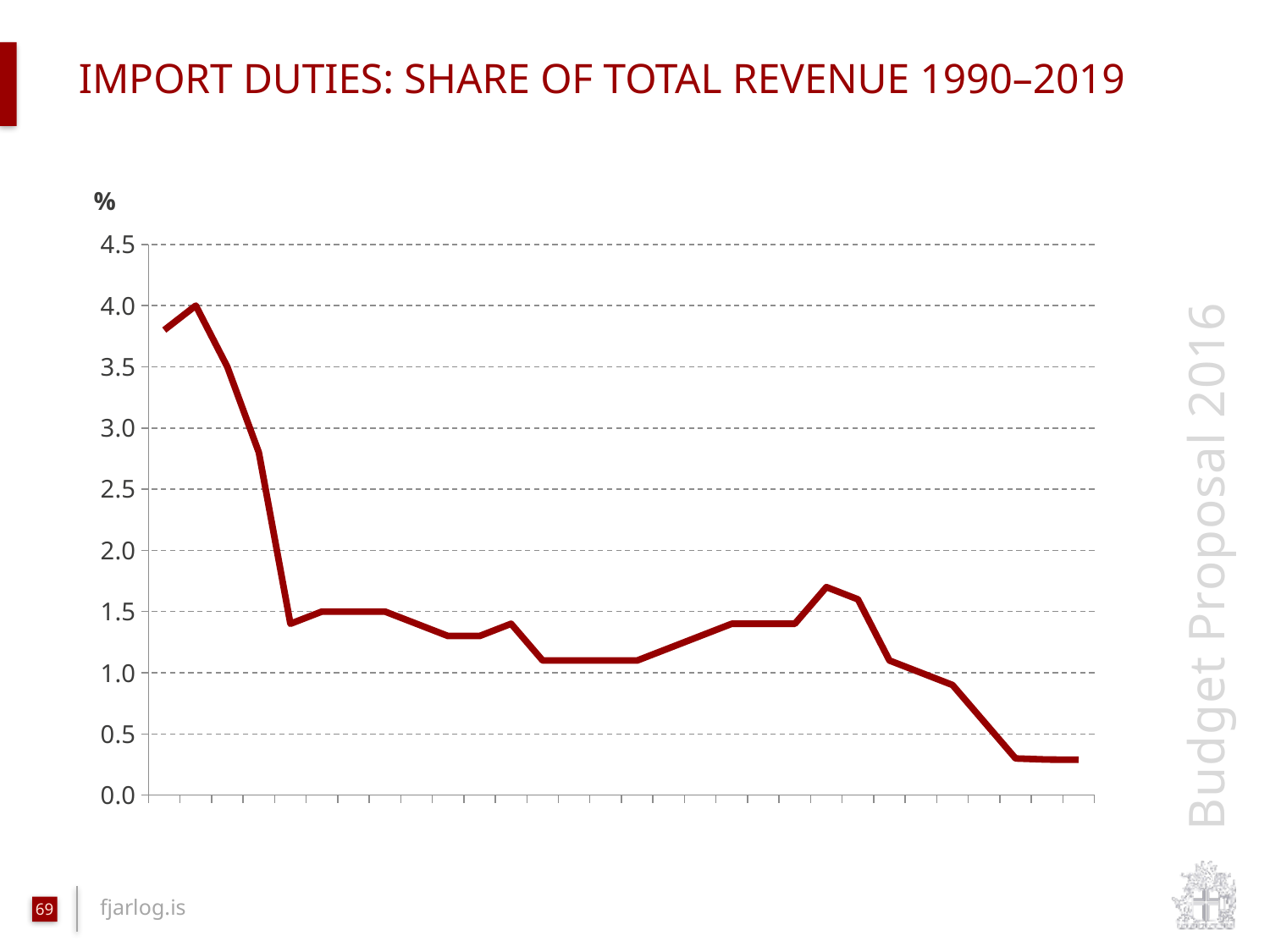
How many lines are plotted on the chart? 1 Is the value at the leftmost point higher or lower than the value at the rightmost point? higher What unit is shown on the vertical axis of the chart? % Is the value at the end of the series (rightmost point) greater or less than 1.0? less Is the lowest value on the line greater or less than 0.5? less Is the highest value on the line greater or less than 3.5? greater What kind of chart is shown on the slide? line chart Overall, does the line rise or fall from left to right? fall What is the title of the chart? IMPORT DUTIES: SHARE OF TOTAL REVENUE 1990–2019